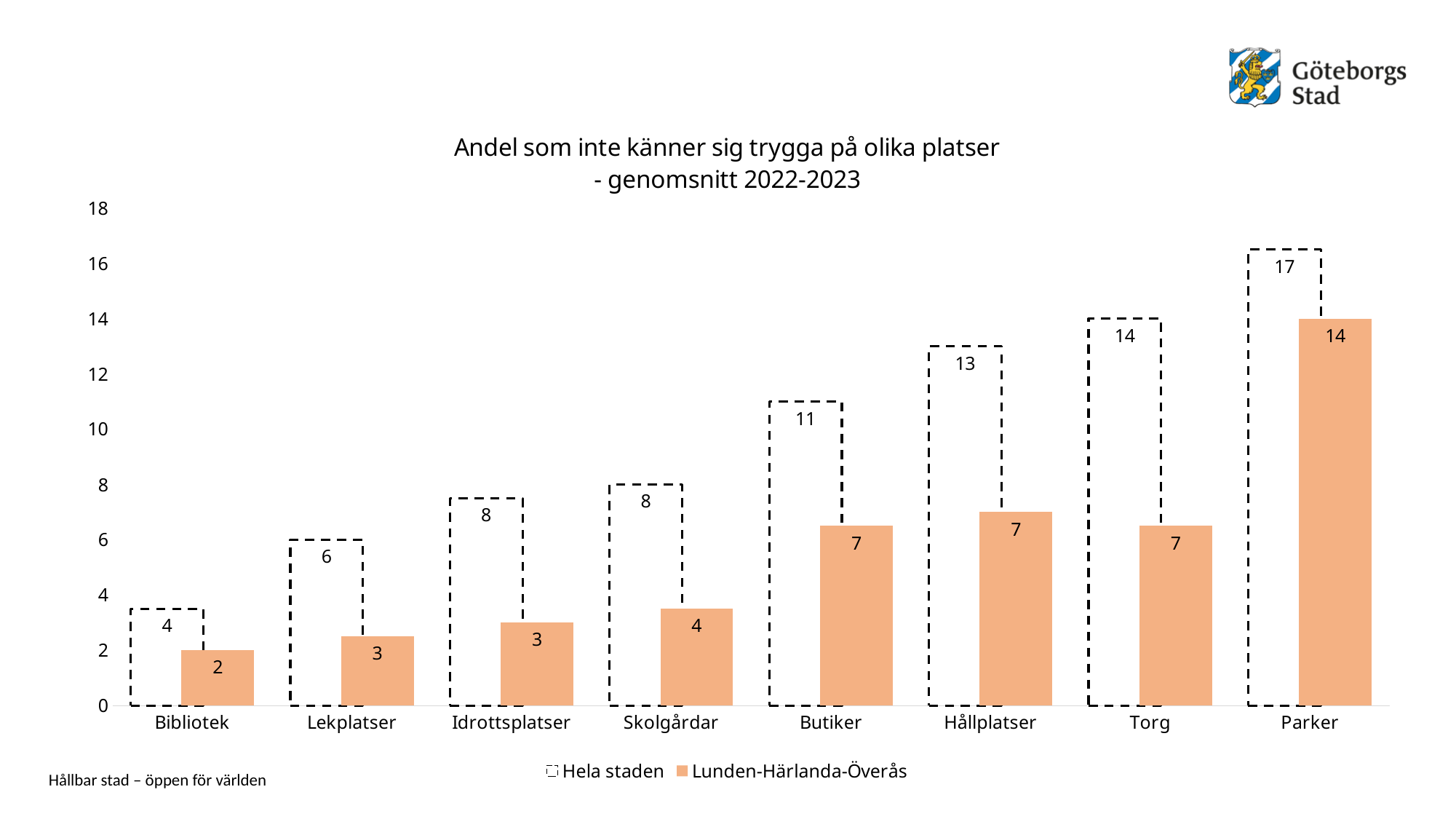
What is the value for Hela staden at Bibliotek? 4 How many series does the legend list? 2 Which series is drawn with a dashed outline? Hela staden What is the value for Lunden-Härlanda-Överås at Butiker? 7 What is the difference between Hela staden and Lunden-Härlanda-Överås at Hållplatser? 6 Which category has the lowest value for Hela staden? Bibliotek Which category has the highest value for Lunden-Härlanda-Överås? Parker How many categories are shown on the x axis? 8 What kind of chart is shown on the slide? Bar chart Do the Hela staden values rise or fall from Bibliotek to Parker? Rise Which is larger at Torg: Hela staden or Lunden-Härlanda-Överås? Hela staden What is the value for Hela staden at Parker? 17